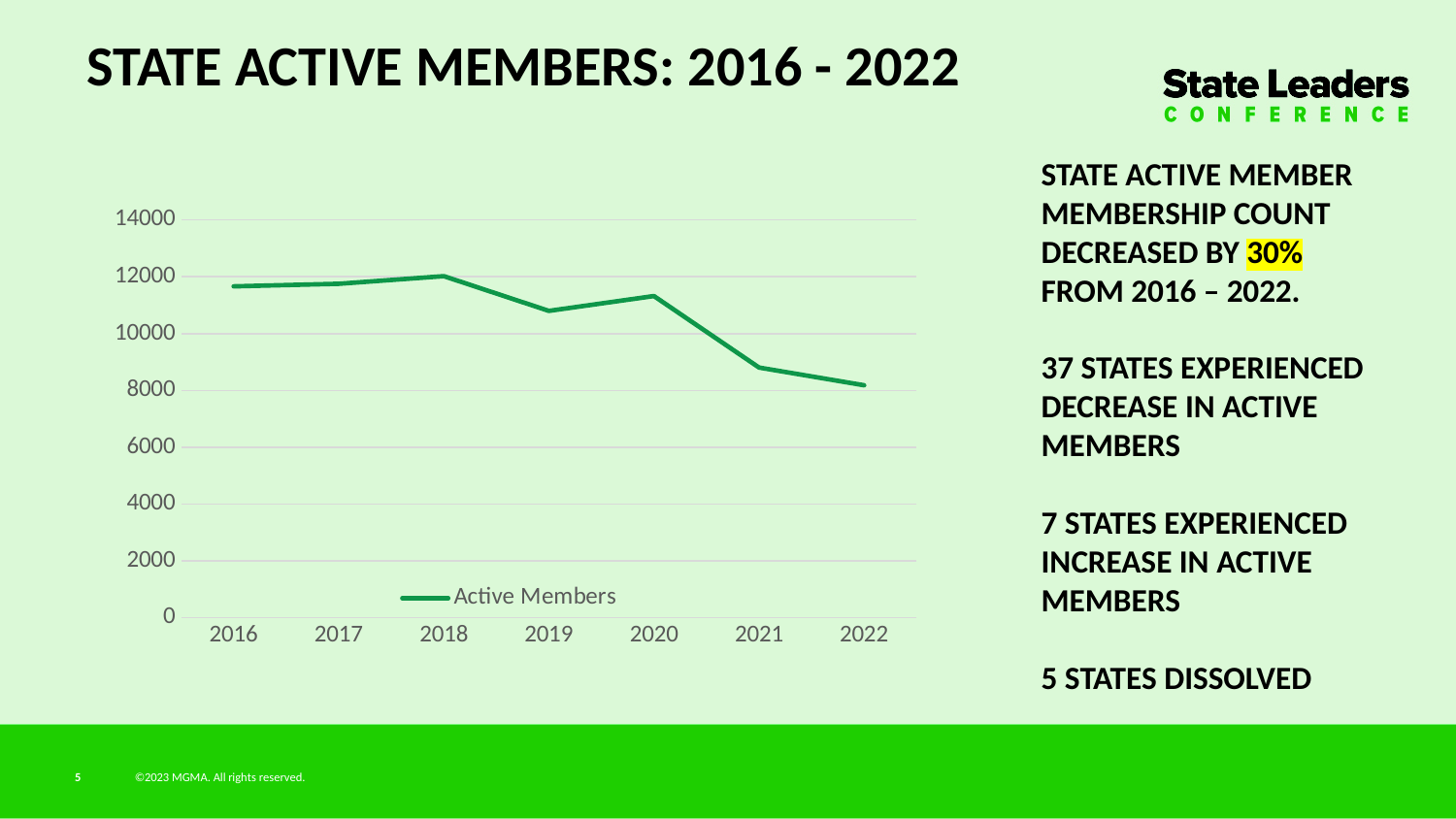
What kind of chart is shown on the slide? line chart Is the value for 2021 greater or less than 8000? greater In which year is the number of active members lowest? 2022 Overall, do the active member values rise or fall from 2016 to 2022? fall What is the title of the chart on the slide? STATE ACTIVE MEMBERS: 2016 - 2022 How many series does the chart legend list? 1 Which year has the higher number of active members, 2019 or 2020? 2020 How many years are plotted along the x axis of the chart? 7 What is the name of the series shown in the chart legend? Active Members Is the value for 2016 greater or less than 10000? greater Is the value for 2022 greater or less than 10000? less